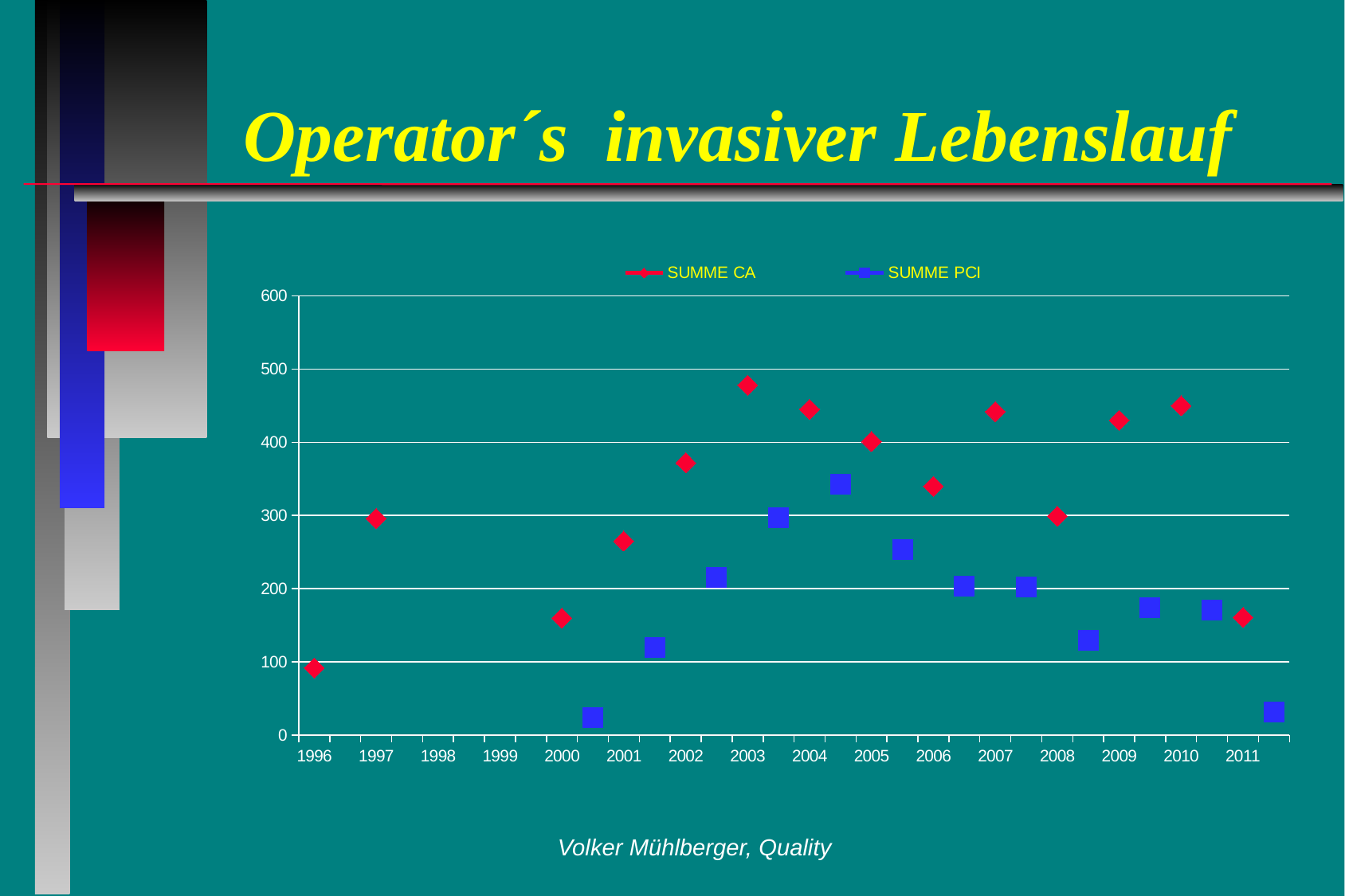
What colour and shape are the markers for SUMME PCI? Blue squares Is the value for SUMME CA in 2003 greater or less than 400? greater What are the two series named in the legend? SUMME CA and SUMME PCI In which year does SUMME CA reach its highest value? 2003 Is the value for SUMME PCI in 2000 greater or less than 100? less How many series does the legend list? 2 In 2005, which series has the larger value, SUMME CA or SUMME PCI? SUMME CA Is the value for SUMME PCI in 2004 greater or less than 300? greater In which year does SUMME CA have its lowest value? 1996 In which year does SUMME PCI reach its highest value? 2004 How many years are labelled on the x axis? 16